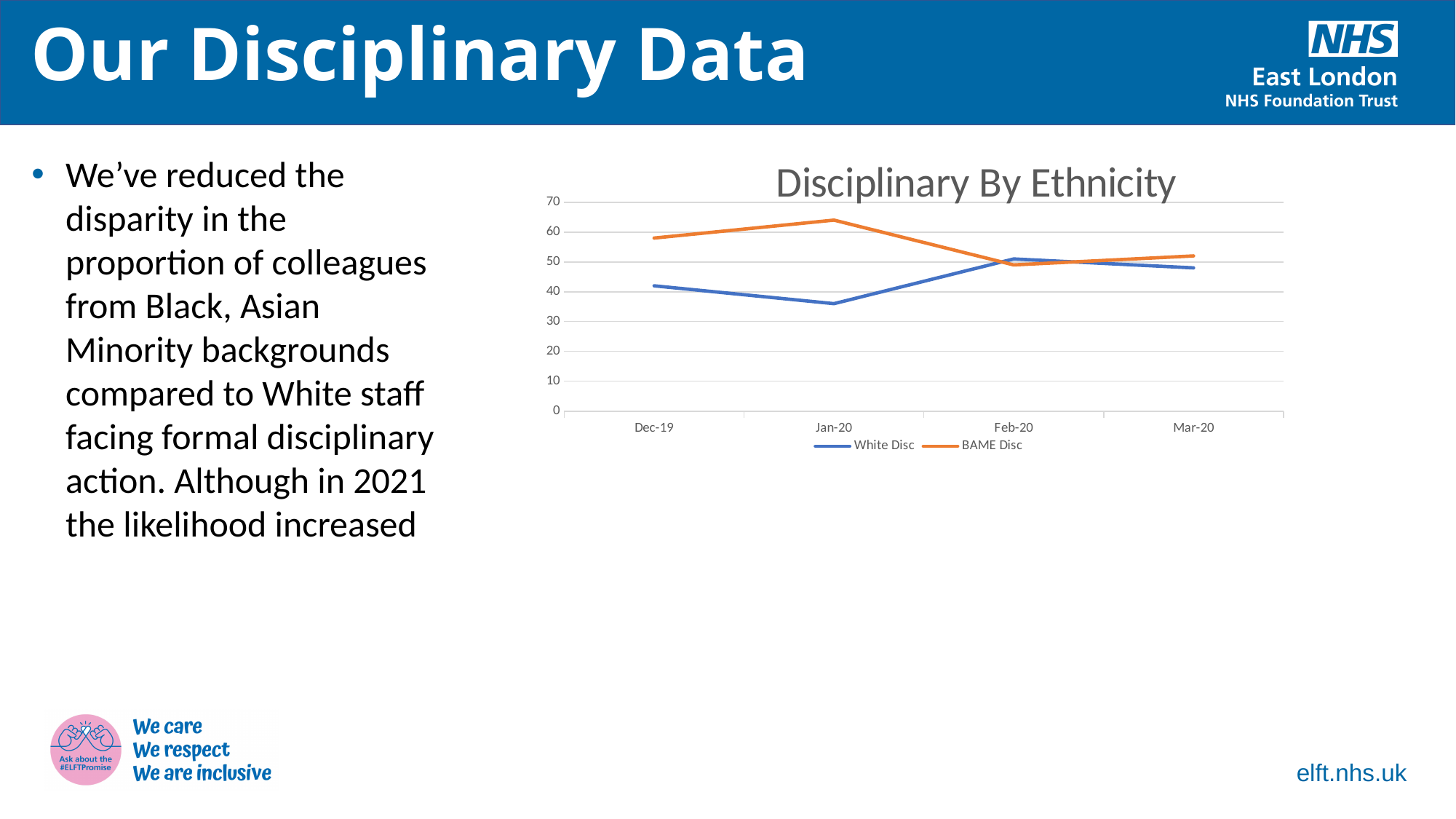
How many series does the chart's legend list? 2 What kind of chart is shown on the slide? Line chart What are the two series named in the legend? White Disc and BAME Disc How many months are plotted along the x axis? 4 Does the BAME Disc line rise or fall from Jan-20 to Feb-20? Fall What is the title of the chart? Disciplinary By Ethnicity In which month is the BAME Disc line at its highest? Jan-20 Is the White Disc value for Jan-20 greater or less than 40? less In which month is the White Disc line at its lowest? Jan-20 Is the BAME Disc value for Dec-19 greater or less than 50? greater In Dec-19, which series has the higher value, White Disc or BAME Disc? BAME Disc Is the BAME Disc value for Jan-20 greater or less than 60? greater